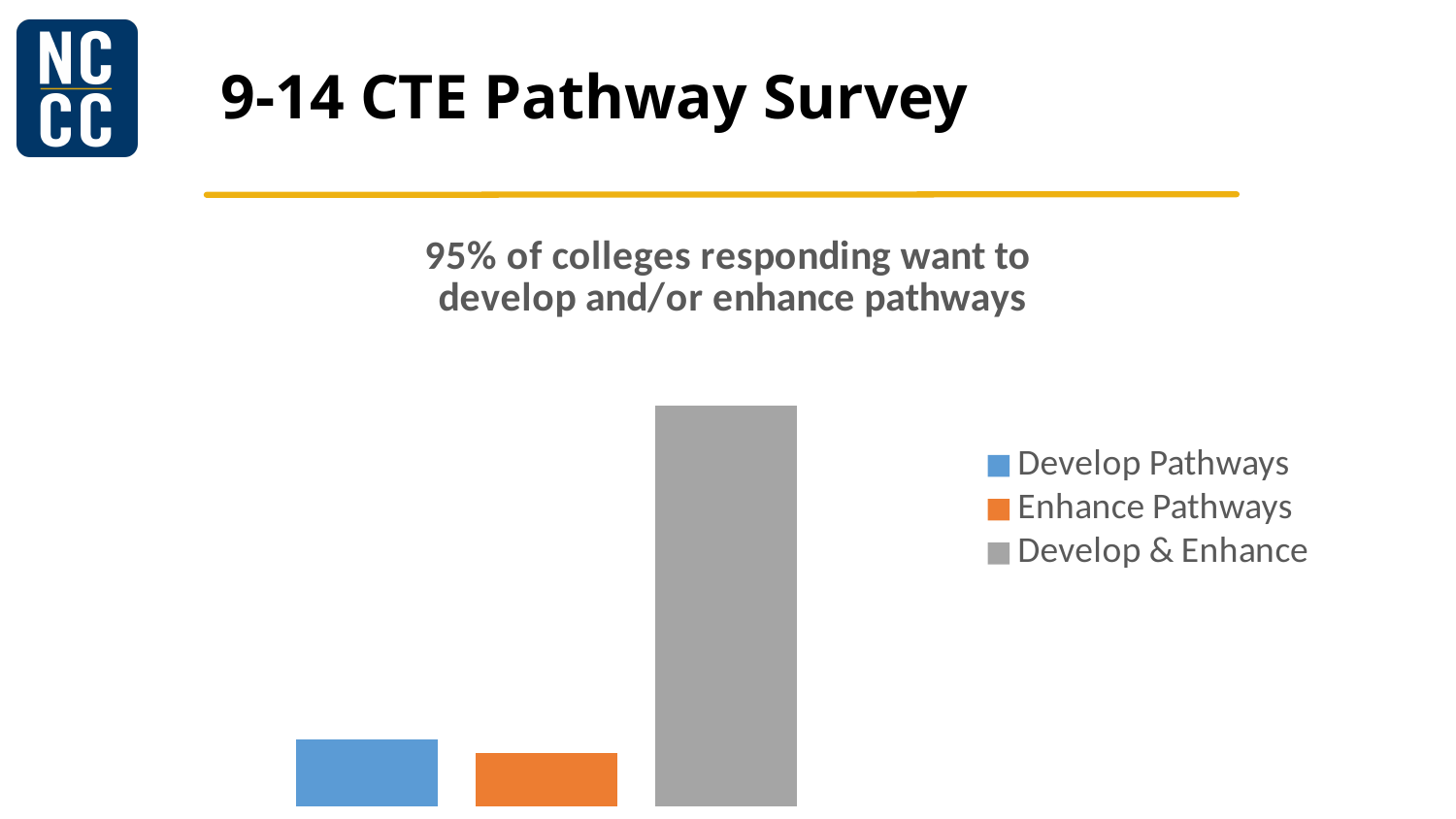
How many series does the chart legend list? 3 What kind of chart is shown on the slide? bar chart How many bars are plotted in the chart? 3 Is the bar for Develop & Enhance taller or shorter than the bar for Enhance Pathways? taller Which series is shown in blue in the chart? Develop Pathways Which colour represents Enhance Pathways in the chart legend? orange Is the bar for Develop & Enhance taller or shorter than the bar for Develop Pathways? taller Which series has the tallest bar in the chart? Develop & Enhance